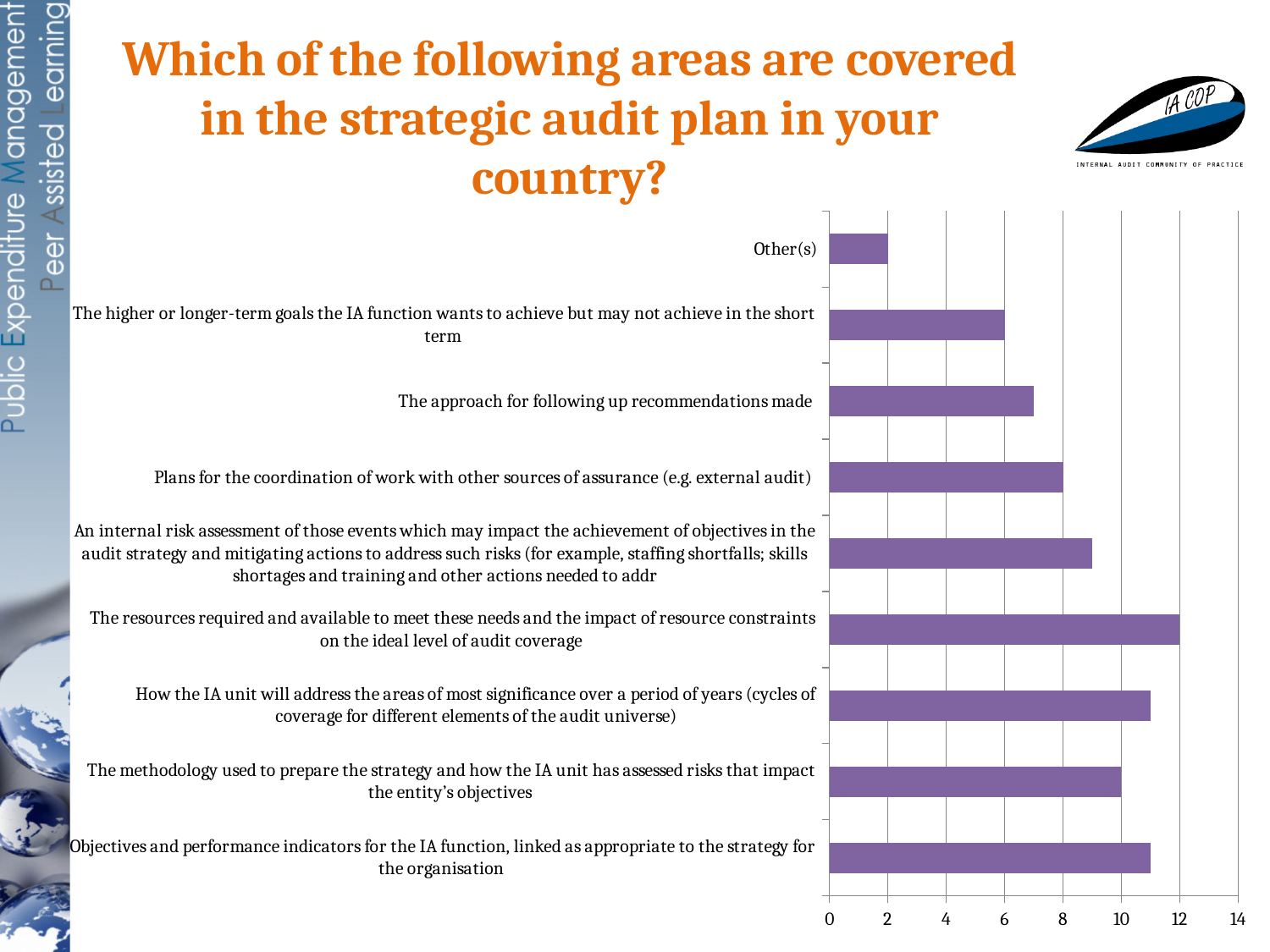
Is the value for 'The approach for following up recommendations made' greater or less than 6? greater What is the value for 'The methodology used to prepare the strategy and how the IA unit has assessed risks that impact the entity's objectives'? 10 What is the difference between the value for 'The resources required and available...' and the value for 'Other(s)'? 10 Which has the larger value: 'The methodology used to prepare the strategy...' or 'Plans for the coordination of work with other sources of assurance'? The methodology used to prepare the strategy and how the IA unit has assessed risks that impact the entity's objectives Which area has the highest value in the chart? The resources required and available to meet these needs and the impact of resource constraints on the ideal level of audit coverage What is the value for 'The higher or longer-term goals the IA function wants to achieve but may not achieve in the short term'? 6 What kind of chart is shown on the slide? bar chart Which category has the lowest value in the chart? Other(s) What is the value for 'Other(s)'? 2 What is the value for 'Plans for the coordination of work with other sources of assurance (e.g. external audit)'? 8 How many categories (answer options) are plotted in the chart? 9 What is the value for 'The resources required and available to meet these needs and the impact of resource constraints on the ideal level of audit coverage'? 12